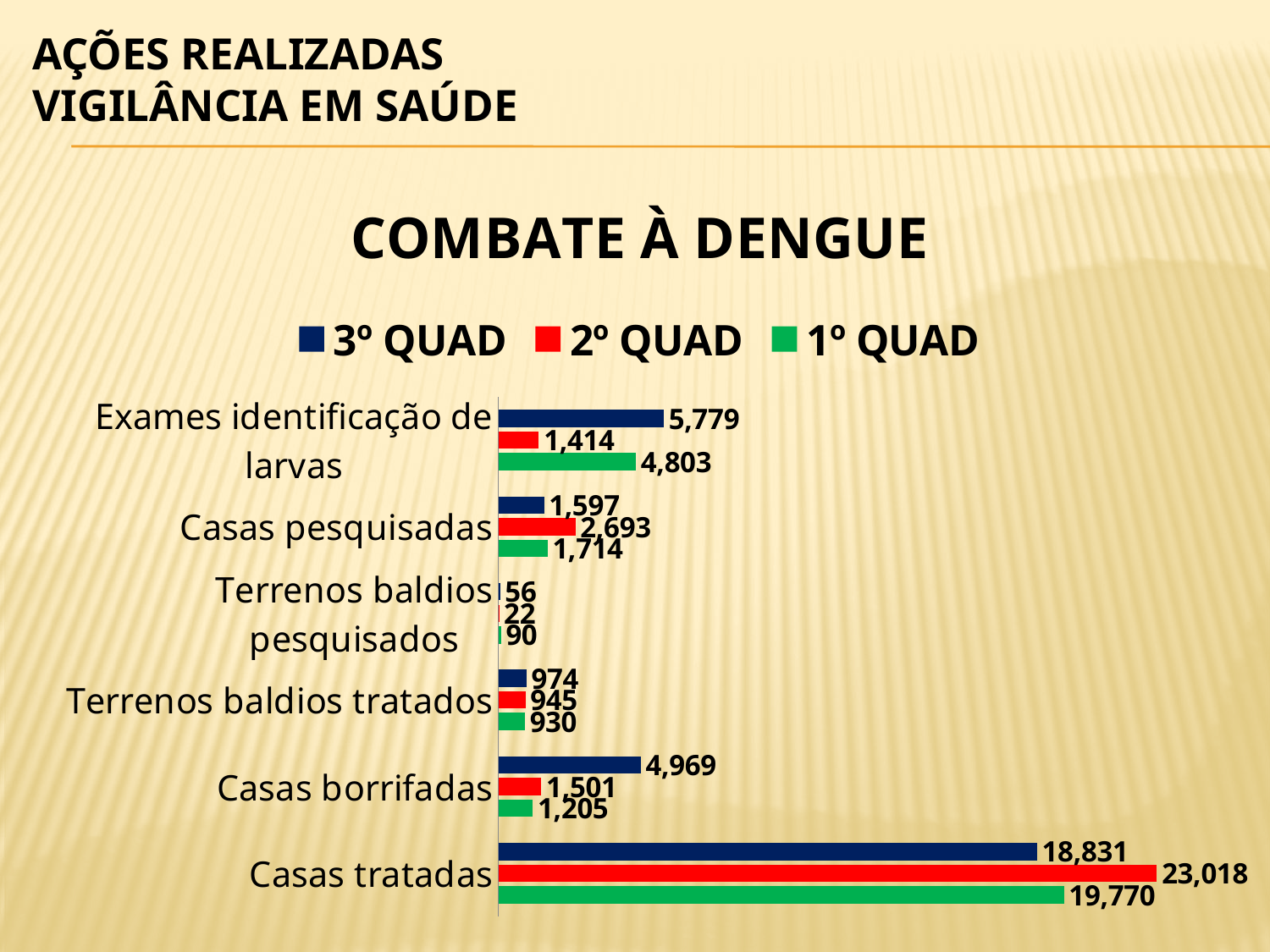
What kind of chart is shown on the slide? Bar chart Which category has the lowest value for 1º QUAD? Terrenos baldios pesquisados What is the value for 2º QUAD in the Casas tratadas category? 23,018 How many categories are shown on the chart? 6 How many series does the legend list? 3 Which category has the highest value for 3º QUAD? Casas tratadas What is the value for 2º QUAD in the Terrenos baldios pesquisados category? 22 What is the value for 1º QUAD in the Casas borrifadas category? 1,205 What is the title of the chart? COMBATE À DENGUE What is the value for 3º QUAD in the Exames identificação de larvas category? 5,779 What is the difference between the 2º QUAD and 3º QUAD values for Casas tratadas? 4,187 Which is larger for Casas pesquisadas: the 2º QUAD value or the 1º QUAD value? 2º QUAD